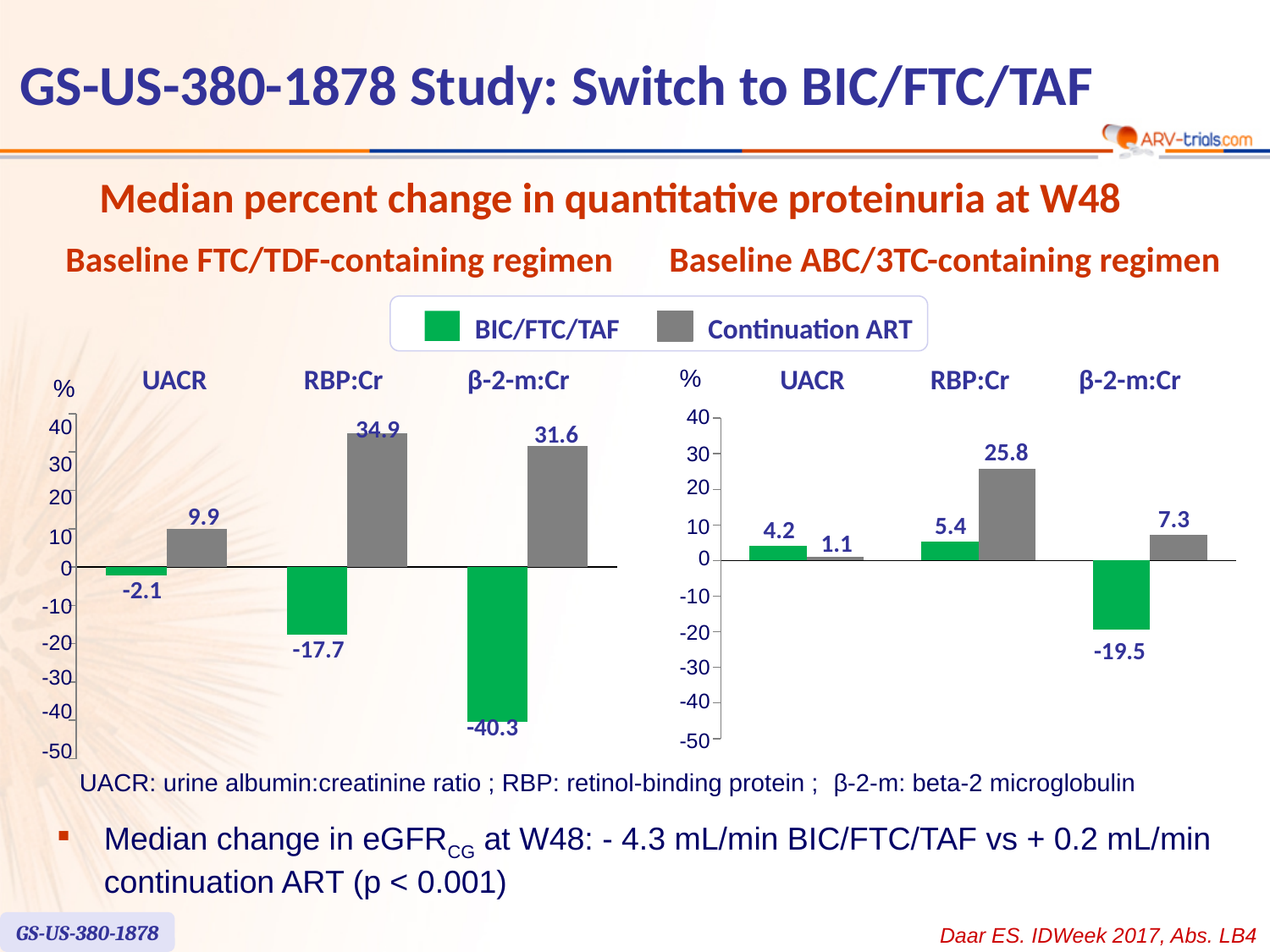
In the Baseline ABC/3TC-containing regimen chart, what is the difference between the Continuation ART and BIC/FTC/TAF values for β-2-m:Cr? 26.8 What kind of chart is the Baseline ABC/3TC-containing regimen chart? Bar chart In the Baseline FTC/TDF-containing regimen chart, which category has the lowest BIC/FTC/TAF value? β-2-m:Cr In the Baseline FTC/TDF-containing regimen chart, what is the value for BIC/FTC/TAF for β-2-m:Cr? -40.3 In the Baseline FTC/TDF-containing regimen chart, what is the difference between the Continuation ART and BIC/FTC/TAF values for RBP:Cr? 52.6 In the Baseline ABC/3TC-containing regimen chart, which category has the highest Continuation ART value? RBP:Cr How many categories are shown on the x axis of the Baseline FTC/TDF-containing regimen chart? 3 In the Baseline ABC/3TC-containing regimen chart, what is the value for Continuation ART for RBP:Cr? 25.8 In the Baseline FTC/TDF-containing regimen chart, what is the value for Continuation ART for RBP:Cr? 34.9 In the Baseline ABC/3TC-containing regimen chart, which is larger for UACR: BIC/FTC/TAF or Continuation ART? BIC/FTC/TAF How many series does the legend list? 2 In the Baseline ABC/3TC-containing regimen chart, what is the value for BIC/FTC/TAF for UACR? 4.2